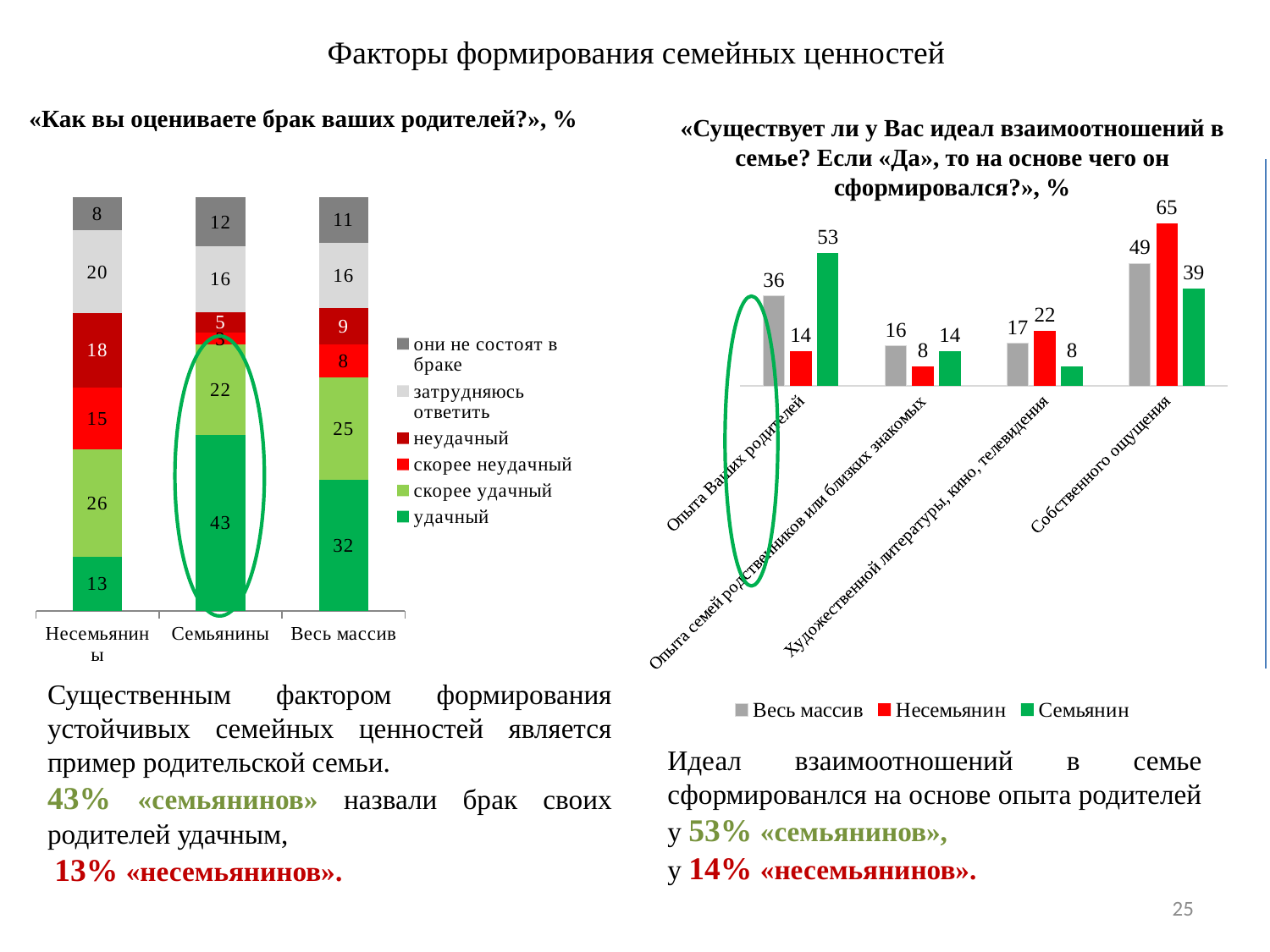
What kind of chart is the left chart «Как вы оцениваете брак ваших родителей?»? Stacked bar chart In the left chart «Как вы оцениваете брак ваших родителей?», what is the value of «удачный» for Семьянины? 43 In the right chart «Существует ли у Вас идеал взаимоотношений в семье?», what is the value for Семьянин for «Опыта Ваших родителей»? 53 In the right chart «Существует ли у Вас идеал взаимоотношений в семье?», how many categories are shown on the x axis? 4 In the right chart «Существует ли у Вас идеал взаимоотношений в семье?», which category has the highest value for Весь массив? Собственного ощущения In the left chart «Как вы оцениваете брак ваших родителей?», what is the total of the stacked bar for Несемьянины? 100 In the left chart «Как вы оцениваете брак ваших родителей?», how many series does the legend list? 6 In the right chart «Существует ли у Вас идеал взаимоотношений в семье?», what is the value for Несемьянин for «Собственного ощущения»? 65 In the left chart «Как вы оцениваете брак ваших родителей?», what is the value of «неудачный» for Весь массив? 9 In the left chart «Как вы оцениваете брак ваших родителей?», what is the difference between the «удачный» values for Семьянины and Несемьянины? 30 In the left chart «Как вы оцениваете брак ваших родителей?», what is the value of «скорее удачный» for Несемьянины? 26 In the right chart «Существует ли у Вас идеал взаимоотношений в семье?», which is larger for «Художественной литературы, кино, телевидения»: Несемьянин or Семьянин? Несемьянин